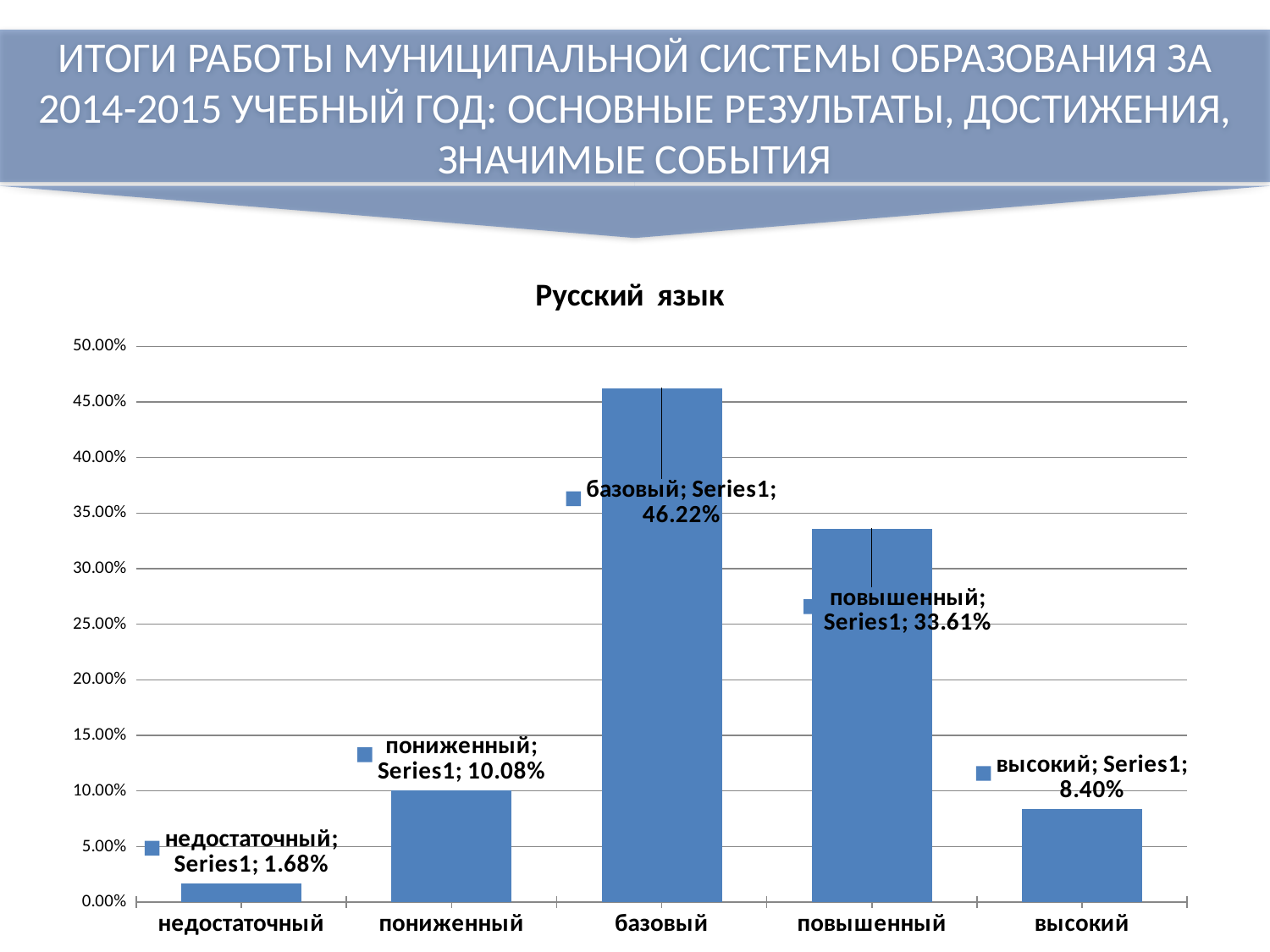
What is the value for недостаточный in the Русский язык chart? 1.68% Which is larger, the value for пониженный or the value for высокий? пониженный How many categories are shown on the x axis of the chart? 5 What is the difference between the values for пониженный and высокий? 1.68% What is the value for повышенный in the Русский язык chart? 33.61% Which category has the lowest value in the Русский язык chart? недостаточный Is the value for повышенный greater or less than 30.00%? greater Which category has the highest value in the Русский язык chart? базовый What is the value for базовый in the Русский язык chart? 46.22% What is the value for высокий in the Русский язык chart? 8.40% What is the difference between the values for базовый and повышенный? 12.61% What kind of chart is shown on the slide? bar chart